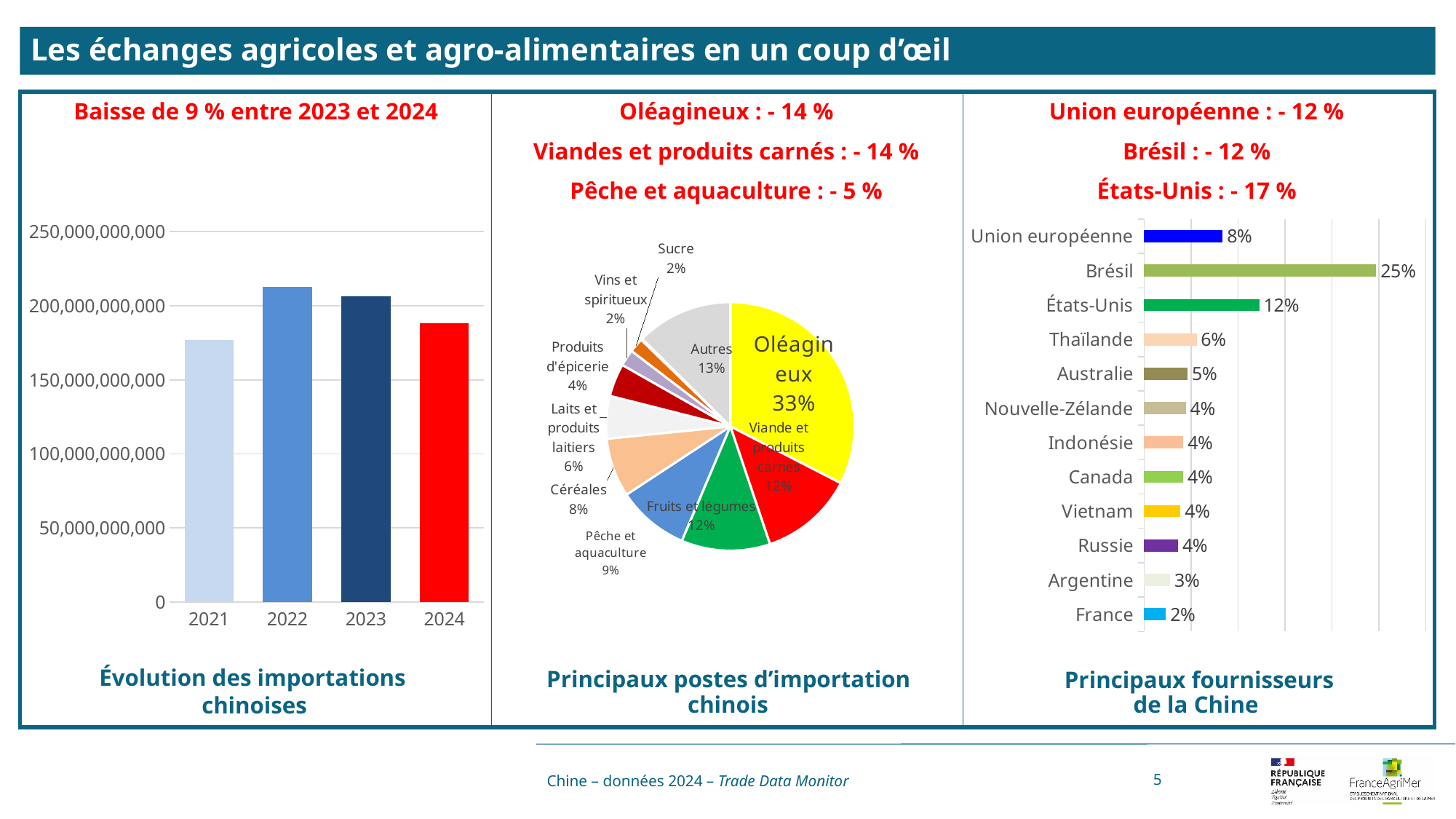
In the chart 'Évolution des importations chinoises', which year has the highest value? 2022 In the pie chart 'Principaux postes d'importation chinois', which category has the smallest share among Sucre, Céréales and Autres? Sucre In the chart 'Principaux fournisseurs de la Chine', which supplier has the lowest share? France In the chart 'Principaux fournisseurs de la Chine', how many suppliers are listed? 12 In the chart 'Principaux fournisseurs de la Chine', which supplier has the highest share? Brésil In the pie chart 'Principaux postes d'importation chinois', what is the value for Pêche et aquaculture? 9% In the chart 'Évolution des importations chinoises', is the value for 2022 greater or less than 200,000,000,000? greater In the pie chart 'Principaux postes d'importation chinois', which is larger: Céréales or Laits et produits laitiers? Céréales In the chart 'Principaux fournisseurs de la Chine', what is the difference between the values for États-Unis and Union européenne? 4% In the chart 'Principaux fournisseurs de la Chine', what is the value for Brésil? 25% In the pie chart 'Principaux postes d'importation chinois', what share does Oléagineux represent? 33% What kind of chart is 'Évolution des importations chinoises'? Bar chart